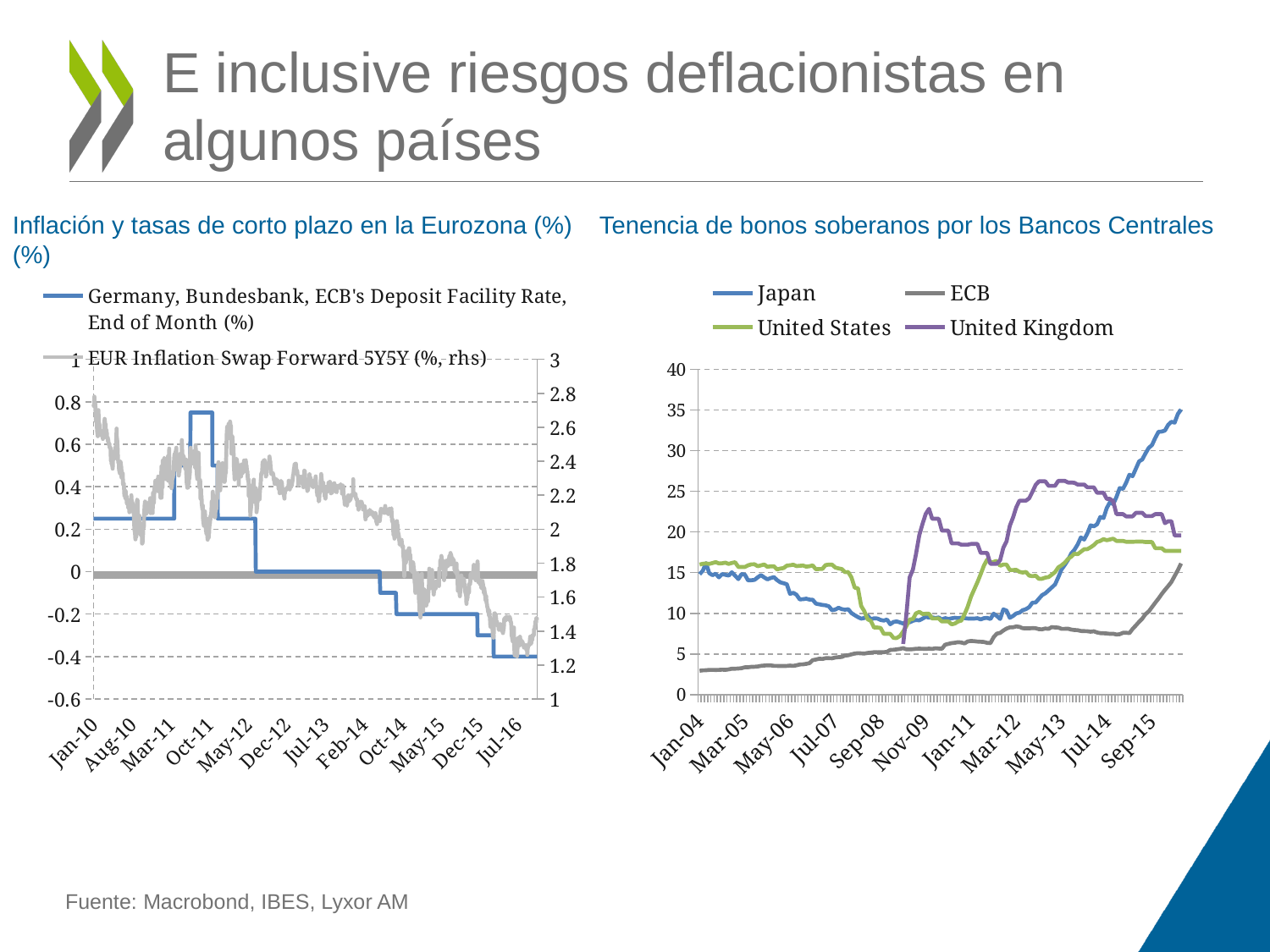
In the right chart, 'Tenencia de bonos soberanos por los Bancos Centrales', is the value for ECB at Jan-04 greater or less than 5? less In the right chart, 'Tenencia de bonos soberanos por los Bancos Centrales', which series has the highest value at the end of the period (Sep-15)? Japan In the right chart, 'Tenencia de bonos soberanos por los Bancos Centrales', does the ECB series rise or fall over the period shown? Rises What kind of chart is the left chart, 'Inflación y tasas de corto plazo en la Eurozona (%)'? Line chart In the left chart, 'Inflación y tasas de corto plazo en la Eurozona (%)', does the EUR Inflation Swap Forward 5Y5Y series rise or fall from Jan-10 to Jul-16? Falls How many series does the legend of the right chart, 'Tenencia de bonos soberanos por los Bancos Centrales', list? 4 In the left chart, 'Inflación y tasas de corto plazo en la Eurozona (%)', what is the value of the ECB's Deposit Facility Rate at the end of the period (Jul-16)? -0.4 In the left chart, 'Inflación y tasas de corto plazo en la Eurozona (%)', which series is plotted on the right-hand axis? EUR Inflation Swap Forward 5Y5Y (%, rhs) How many series does the legend of the left chart, 'Inflación y tasas de corto plazo en la Eurozona (%)', list? 2 What kind of chart is the right chart, 'Tenencia de bonos soberanos por los Bancos Centrales'? Line chart In the right chart, 'Tenencia de bonos soberanos por los Bancos Centrales', is the value for Japan at the end of the period greater or less than 30? greater In the right chart, 'Tenencia de bonos soberanos por los Bancos Centrales', which series has the lowest value at the end of the period (Sep-15)? ECB